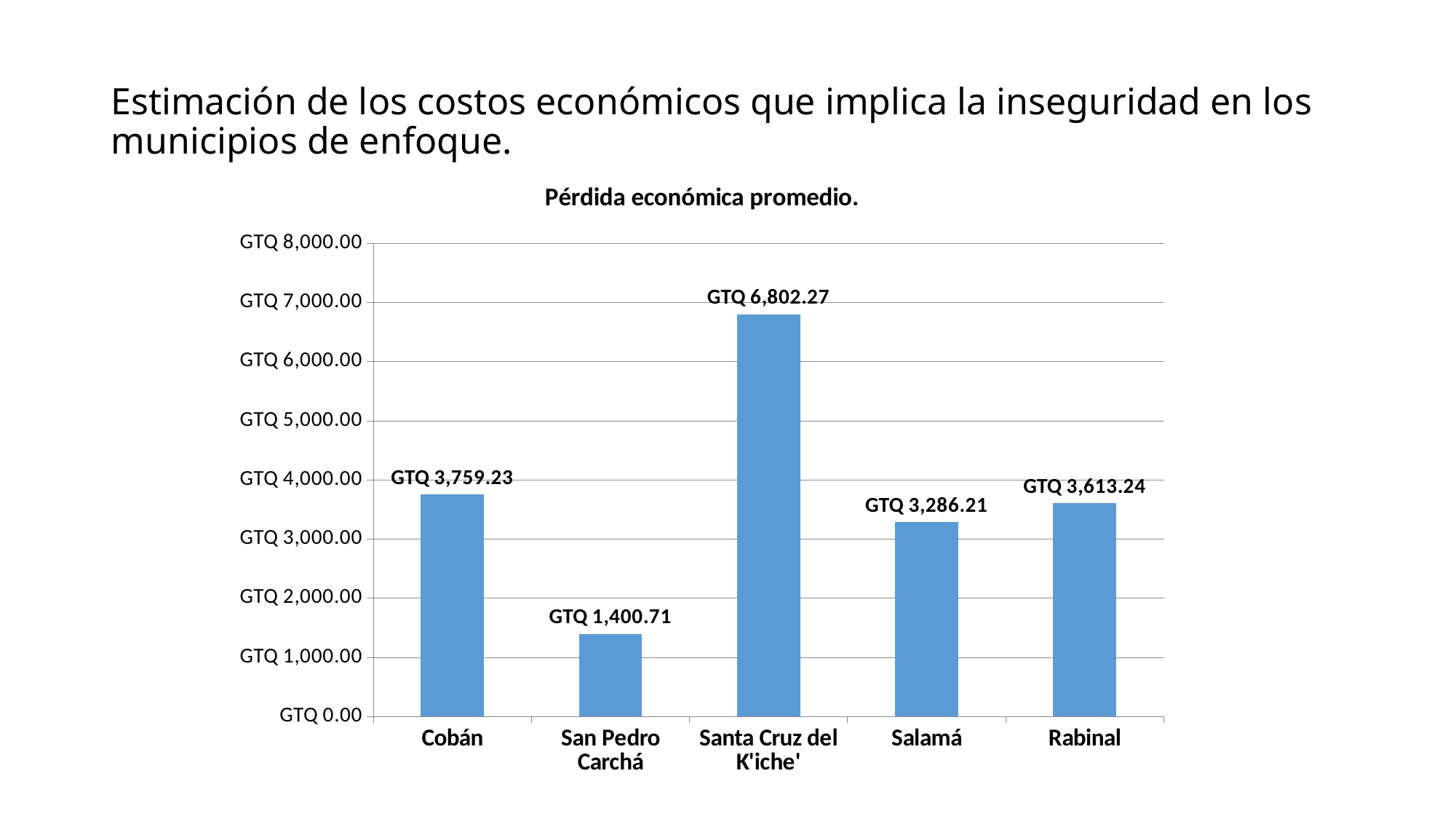
What type of chart is shown on the slide? Bar chart What is the difference between the values for Cobán and Salamá? GTQ 473.02 Is the value for Santa Cruz del K'iche' greater or less than GTQ 6,000.00? greater What is the value shown for San Pedro Carchá? GTQ 1,400.71 Which municipality has the highest average economic loss? Santa Cruz del K'iche' What is the average economic loss shown for Cobán? GTQ 3,759.23 What is the value shown for Salamá? GTQ 3,286.21 What is the difference between the values for Santa Cruz del K'iche' and San Pedro Carchá? GTQ 5,401.56 Which has a larger value, Cobán or Rabinal? Cobán What is the value shown for Rabinal? GTQ 3,613.24 Which municipality has the lowest average economic loss? San Pedro Carchá How many municipalities are shown in the chart? 5